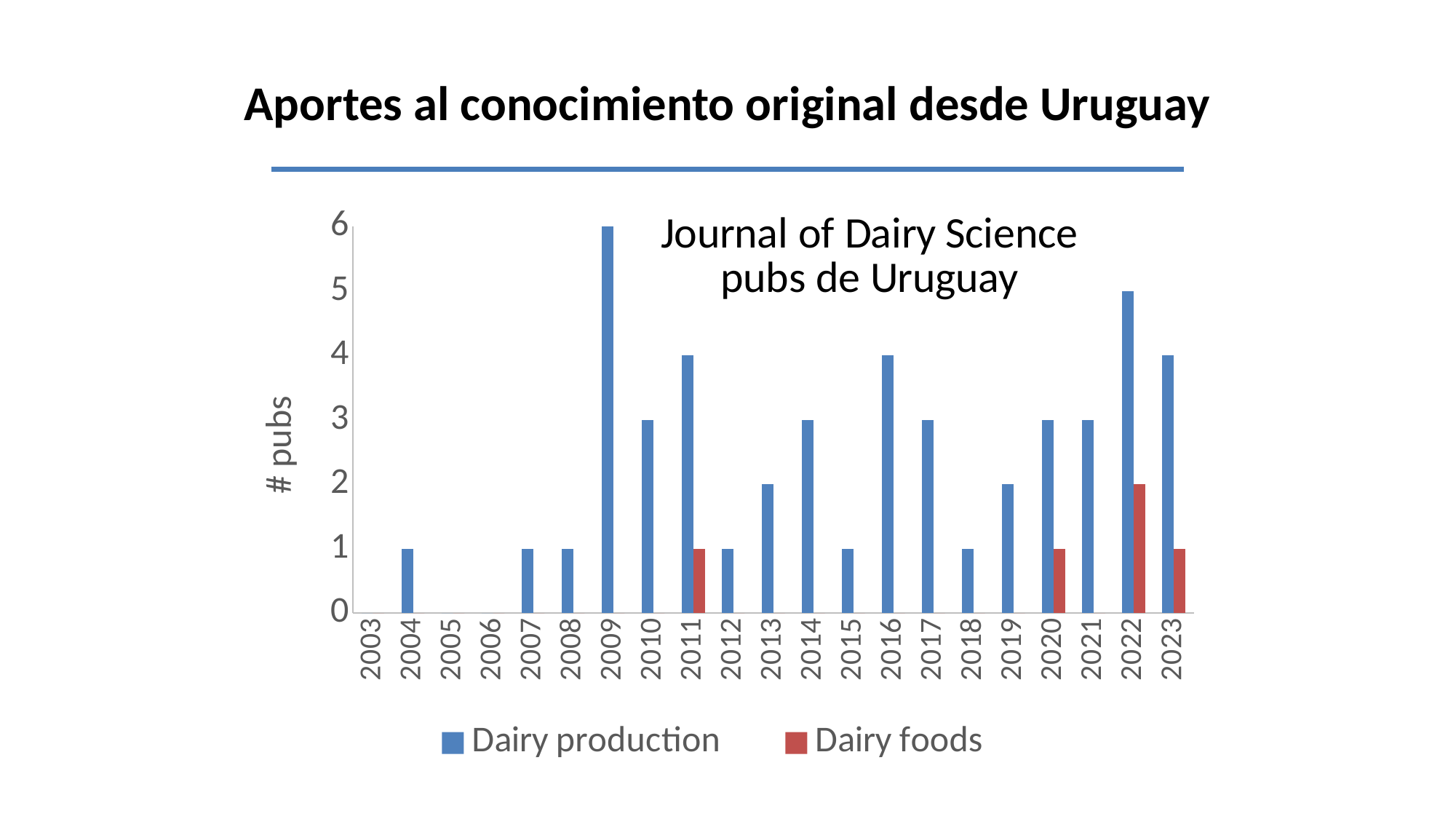
What is the title of the chart? Journal of Dairy Science pubs de Uruguay What is the Dairy production value for 2022? 5 How many series does the legend list? 2 Which year has the highest value for Dairy foods? 2022 What is the label of the y axis? # pubs What is the difference between the Dairy production values for 2009 and 2022? 1 What is the Dairy foods value for 2022? 2 What is the Dairy production value for 2009? 6 How many years are shown on the x axis? 21 Which is larger, the Dairy production value for 2011 or for 2013? 2011 Which year has the highest value for Dairy production? 2009 What type of chart is shown on the slide? bar chart